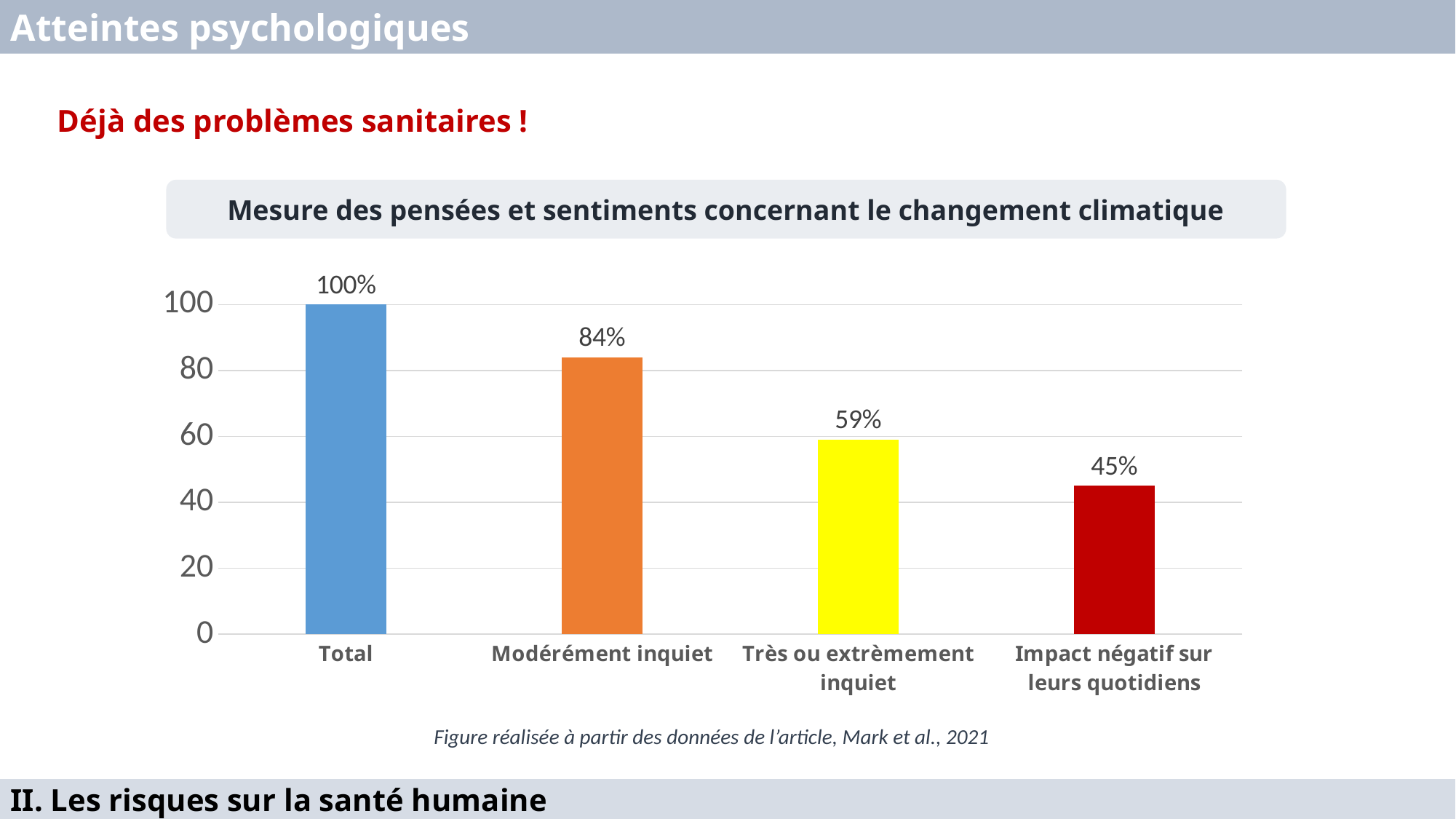
What is the value for "Modérément inquiet"? 84% What is the value for "Total"? 100% What is the title of the chart? Mesure des pensées et sentiments concernant le changement climatique Which is larger, the value for "Modérément inquiet" or the value for "Impact négatif sur leurs quotidiens"? Modérément inquiet Which category has the lowest value? Impact négatif sur leurs quotidiens What is the difference between the values for "Modérément inquiet" and "Très ou extrèmement inquiet"? 25% How many categories are shown on the x axis? 4 What is the difference between the values for "Très ou extrèmement inquiet" and "Impact négatif sur leurs quotidiens"? 14% What is the value for "Très ou extrèmement inquiet"? 59% What kind of chart is shown on the slide? Bar chart Which category has the highest value? Total What is the value for "Impact négatif sur leurs quotidiens"? 45%